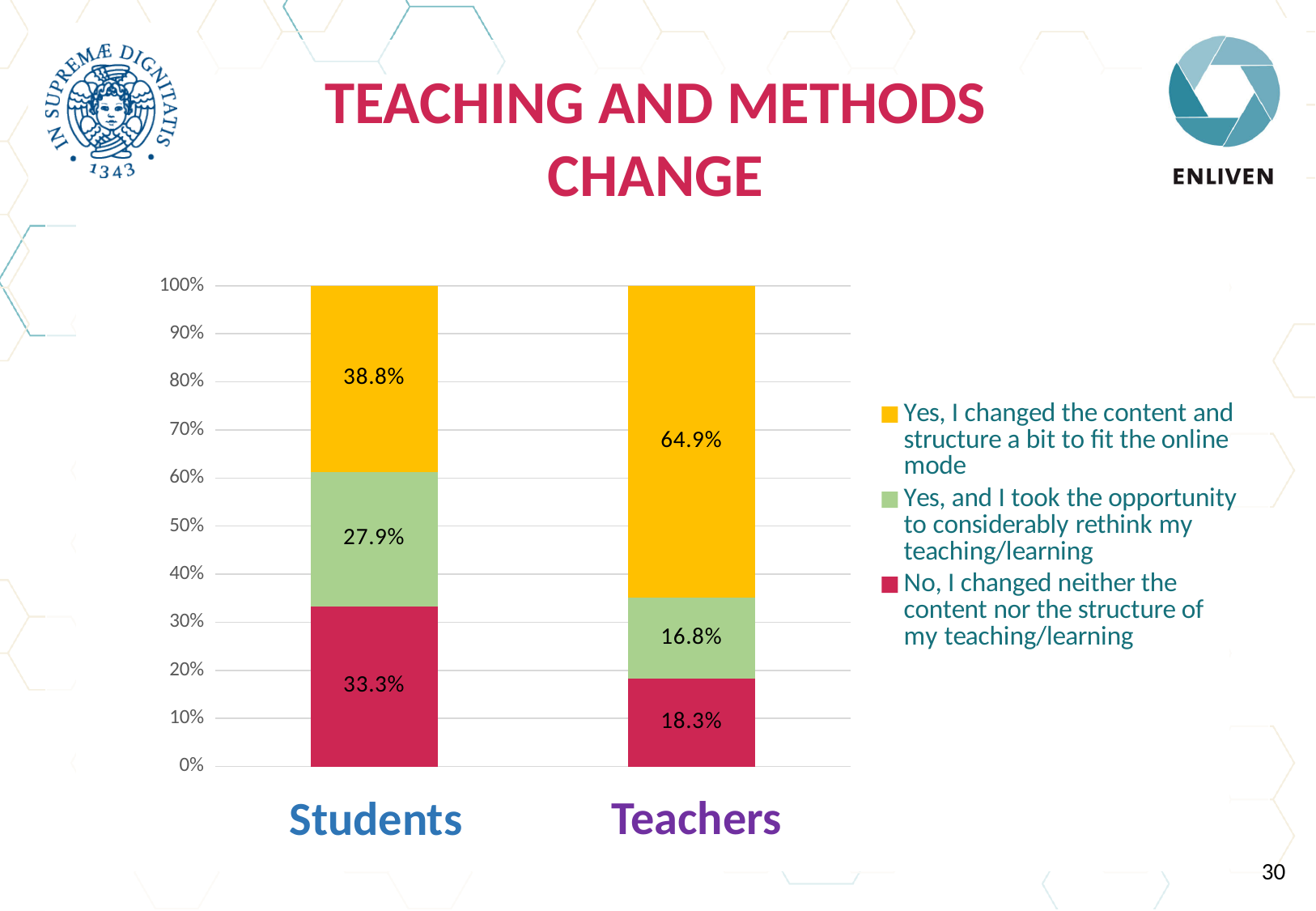
Which group has the larger share for 'Yes, I changed the content and structure a bit to fit the online mode', Students or Teachers? Teachers How many series does the legend list? 3 What is the difference between the Teachers' and Students' shares for 'Yes, I changed the content and structure a bit to fit the online mode'? 26.1% Which group has the larger share for 'No, I changed neither the content nor the structure of my teaching/learning', Students or Teachers? Students What kind of chart is shown on the slide? Stacked bar chart What is the difference between the Students' and Teachers' shares for 'No, I changed neither the content nor the structure of my teaching/learning'? 15.0% What percentage of Students said they changed the content and structure a bit to fit the online mode? 38.8% What percentage of Students said they changed neither the content nor the structure of their teaching/learning? 33.3% What percentage of Teachers took the opportunity to considerably rethink their teaching/learning? 16.8% What percentage of Teachers said they changed the content and structure a bit to fit the online mode? 64.9% Which response category is the largest for Teachers? Yes, I changed the content and structure a bit to fit the online mode Which response category is the smallest for Students? Yes, and I took the opportunity to considerably rethink my teaching/learning